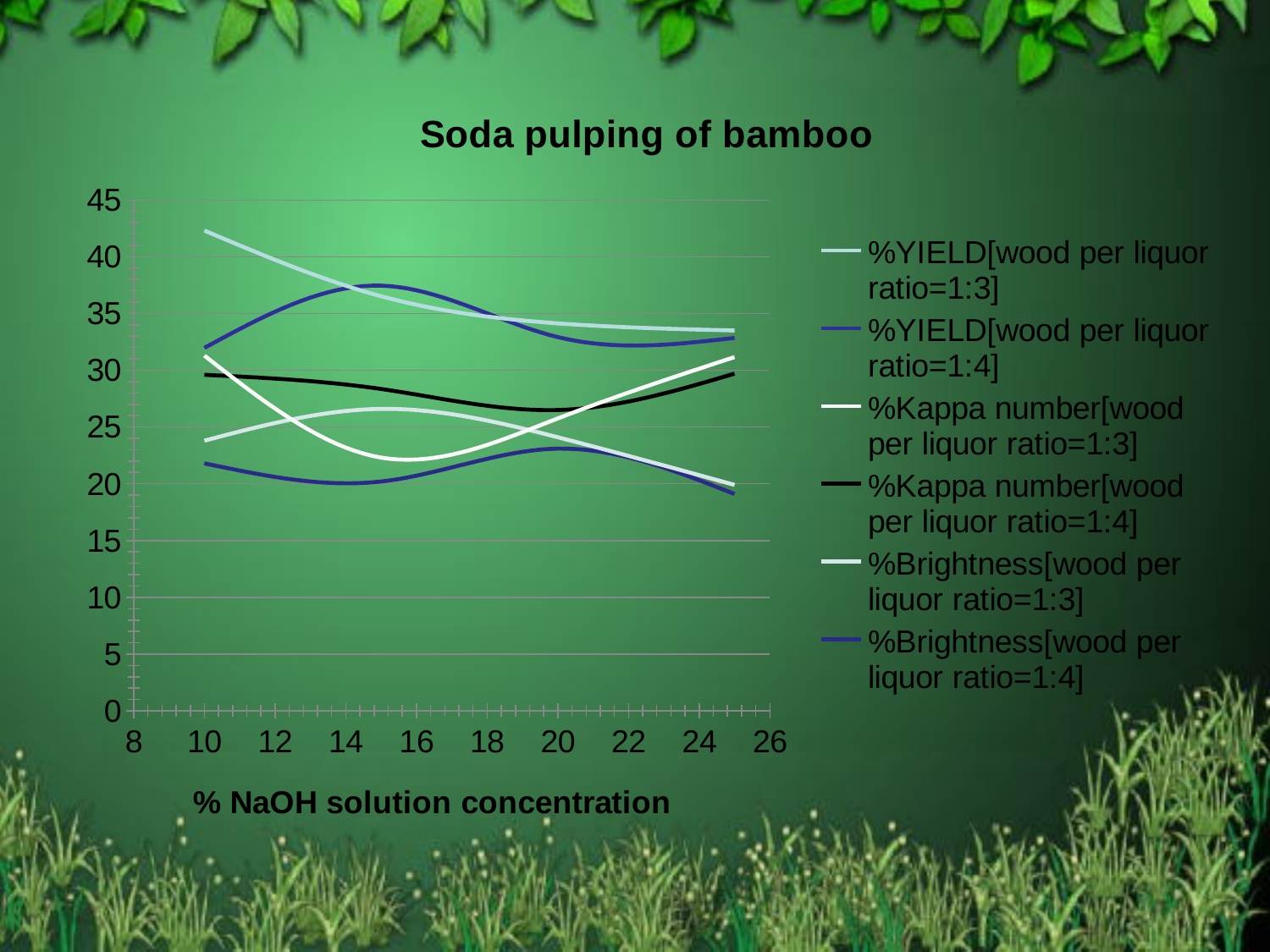
Is the value of %YIELD[wood per liquor ratio=1:3] at 10% NaOH greater or less than 40? greater How many series does the legend list? 6 Which series has the highest value at 10% NaOH? %YIELD[wood per liquor ratio=1:3] Is the value of %Brightness[wood per liquor ratio=1:4] at 10% NaOH greater or less than 25? less Is the value of %Kappa number[wood per liquor ratio=1:4] at 10% NaOH greater or less than 25? greater What is the title of the chart? Soda pulping of bamboo At 10% NaOH, which is larger: %YIELD[wood per liquor ratio=1:3] or %YIELD[wood per liquor ratio=1:4]? %YIELD[wood per liquor ratio=1:3] At 15% NaOH, which is larger: %Kappa number[wood per liquor ratio=1:3] or %Kappa number[wood per liquor ratio=1:4]? %Kappa number[wood per liquor ratio=1:4] What kind of chart is shown on the slide? line chart What is the label of the x axis? % NaOH solution concentration Does the %YIELD[wood per liquor ratio=1:3] line rise or fall as the NaOH concentration increases from 10 to 25? fall